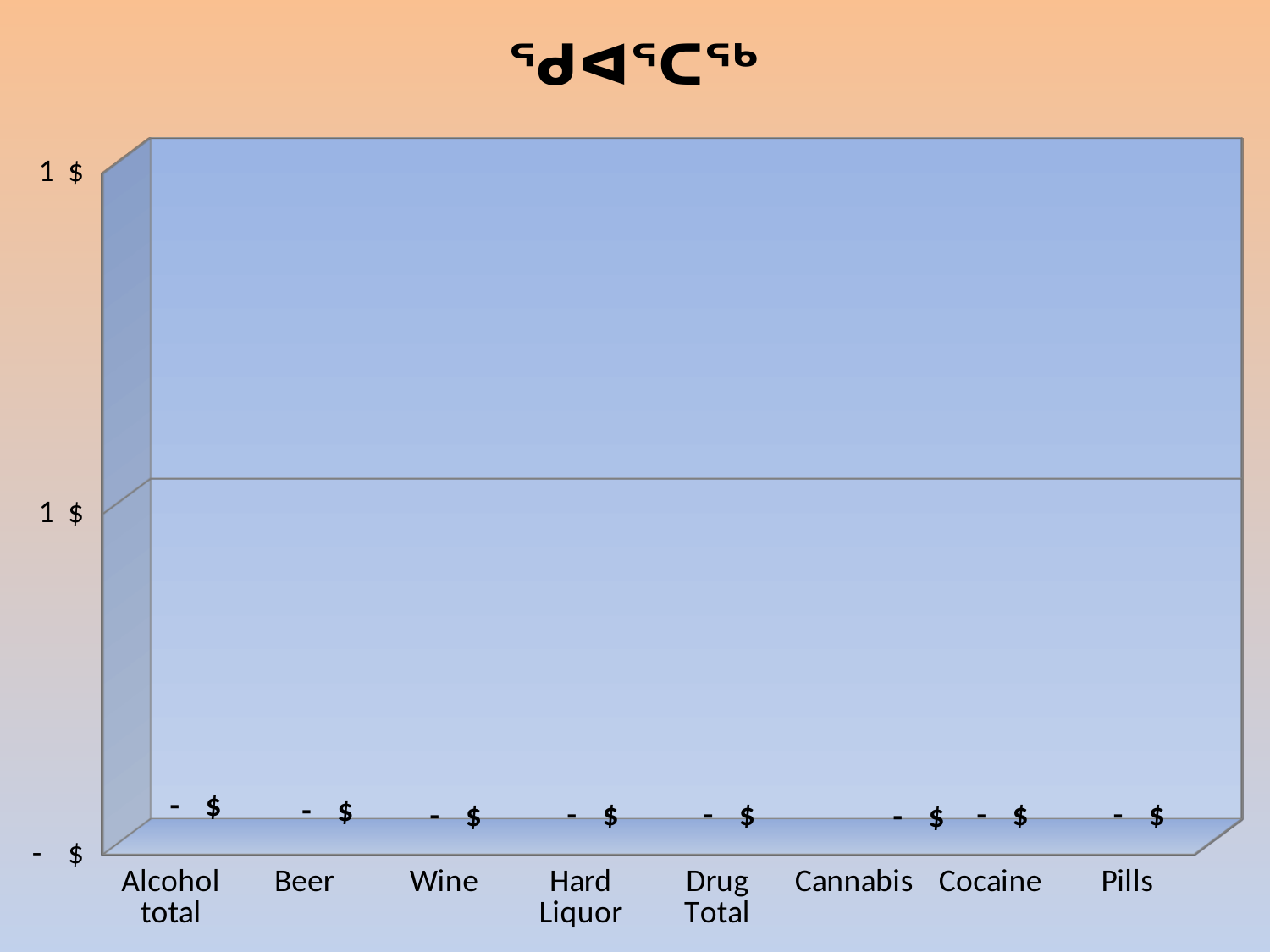
What value is labelled for Cannabis in the chart? - $ What is the last category label on the x axis of the chart? Pills How many categories are shown along the x axis of the chart? 8 What is the first category label on the x axis of the chart? Alcohol total What value is labelled for Pills in the chart? - $ What kind of chart is shown on the slide? bar chart What value is labelled for Drug Total in the chart? - $ What value is labelled for Beer in the chart? - $ What value is labelled for Alcohol total in the chart? - $